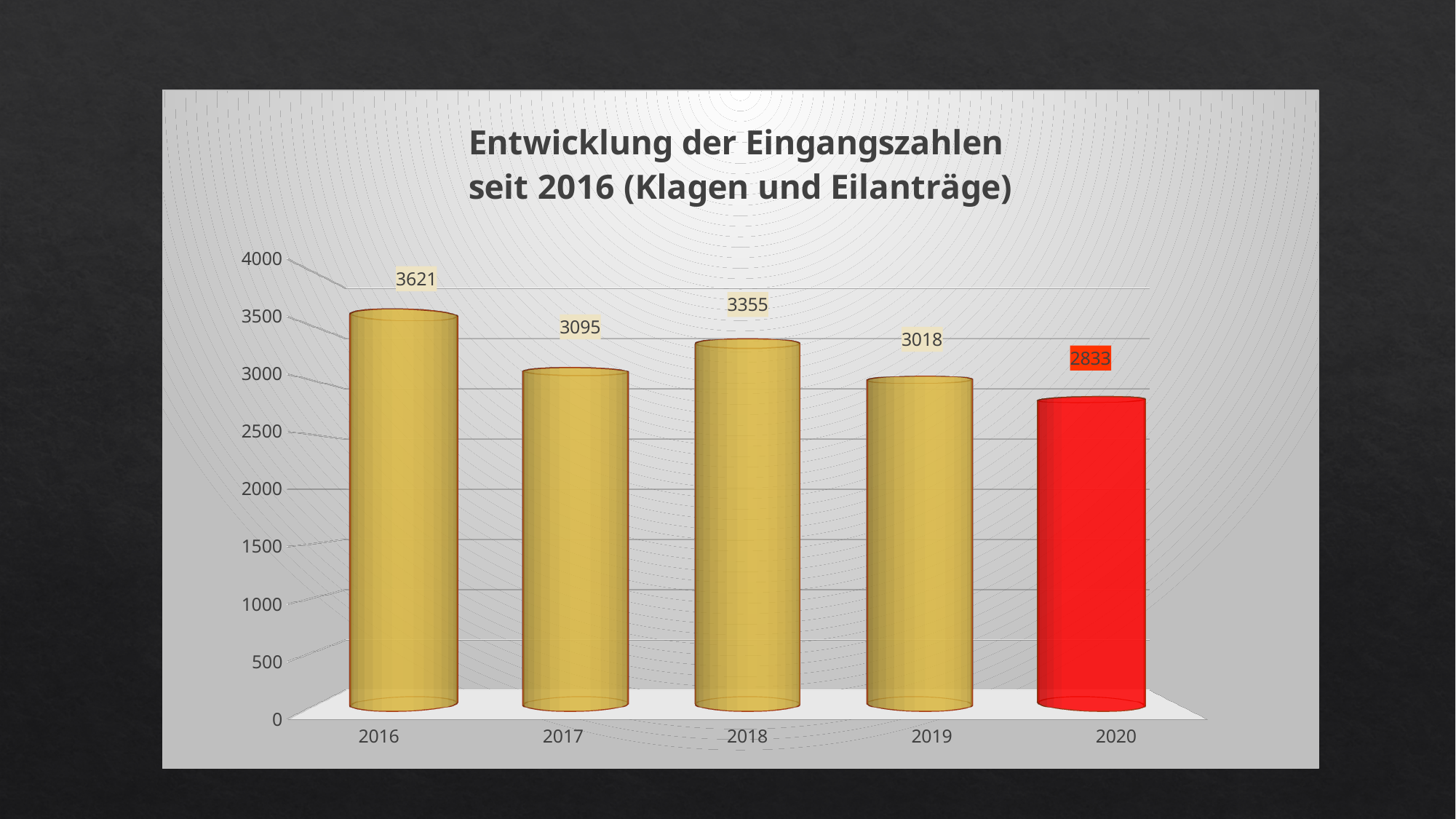
What is the value for 2020? 2833 Which is larger, the value for 2017 or the value for 2018? 2018 How many years are shown on the x axis? 5 What is the value for 2018? 3355 What is the difference between the values for 2016 and 2020? 788 Which year has the highest value? 2016 Which bar is coloured red instead of gold? 2020 Which year has the lowest value? 2020 Is the value for 2019 greater or less than 3500? less What is the value for 2016? 3621 What kind of chart is shown on the slide? bar chart What is the difference between the values for 2018 and 2019? 337